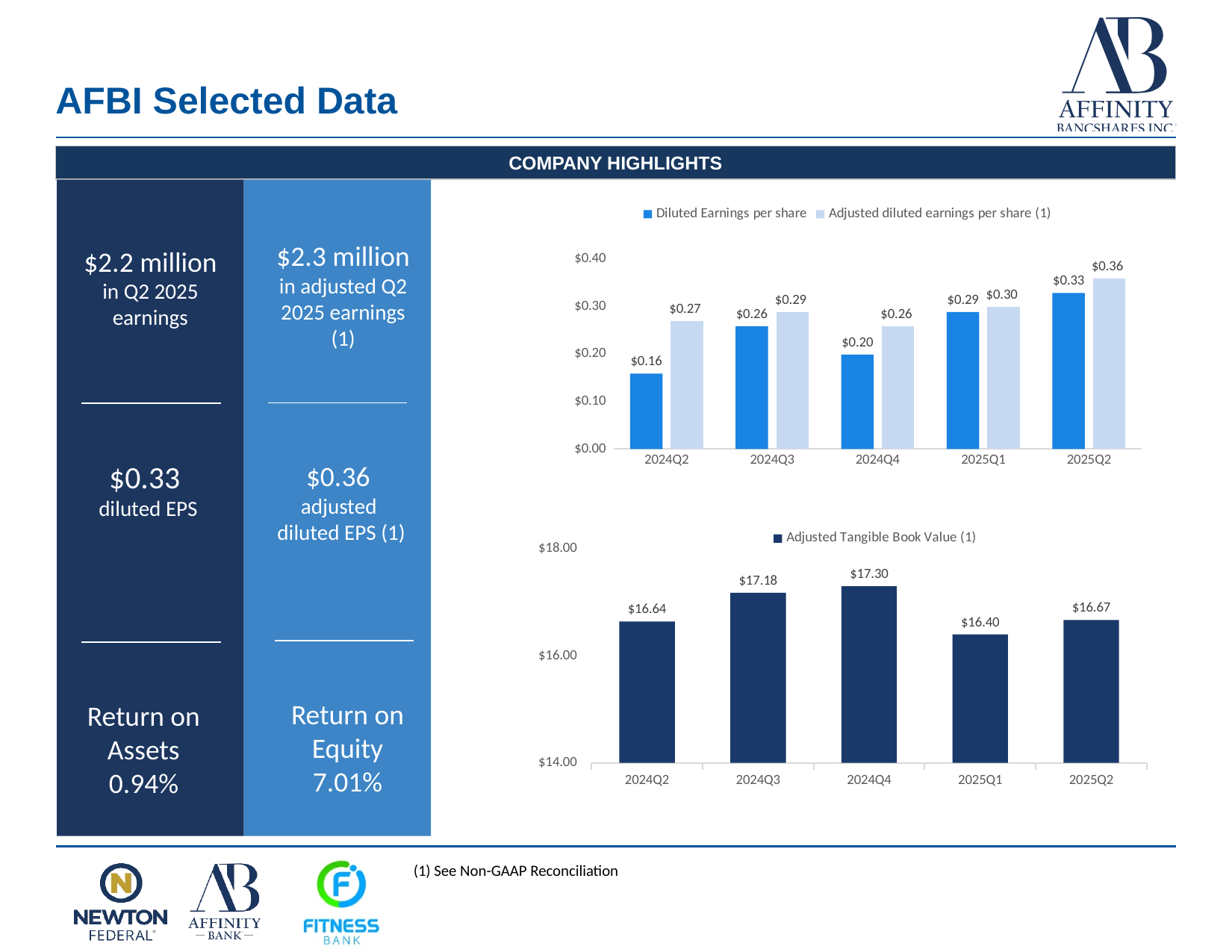
In the top chart, what is the difference between Adjusted diluted earnings per share (1) and Diluted Earnings per share for 2024Q2? $0.11 In the bottom chart (Adjusted Tangible Book Value), how many quarters are shown on the x axis? 5 What kind of chart is the bottom chart (Adjusted Tangible Book Value)? Bar chart In the top chart, which quarter has the lowest Diluted Earnings per share? 2024Q2 In the bottom chart (Adjusted Tangible Book Value), which quarter has the lowest value? 2025Q1 In the bottom chart (Adjusted Tangible Book Value), what is the difference between 2024Q4 and 2025Q1? $0.90 In the top chart, how many series does the legend list? 2 In the bottom chart (Adjusted Tangible Book Value), which quarter has the highest value? 2024Q4 In the top chart, which quarter has the highest Adjusted diluted earnings per share (1)? 2025Q2 In the top chart, what is the Adjusted diluted earnings per share (1) value for 2025Q2? $0.36 In the bottom chart (Adjusted Tangible Book Value), what is the value for 2025Q1? $16.40 In the top chart (Diluted Earnings per share), what is the Diluted Earnings per share value for 2024Q4? $0.20